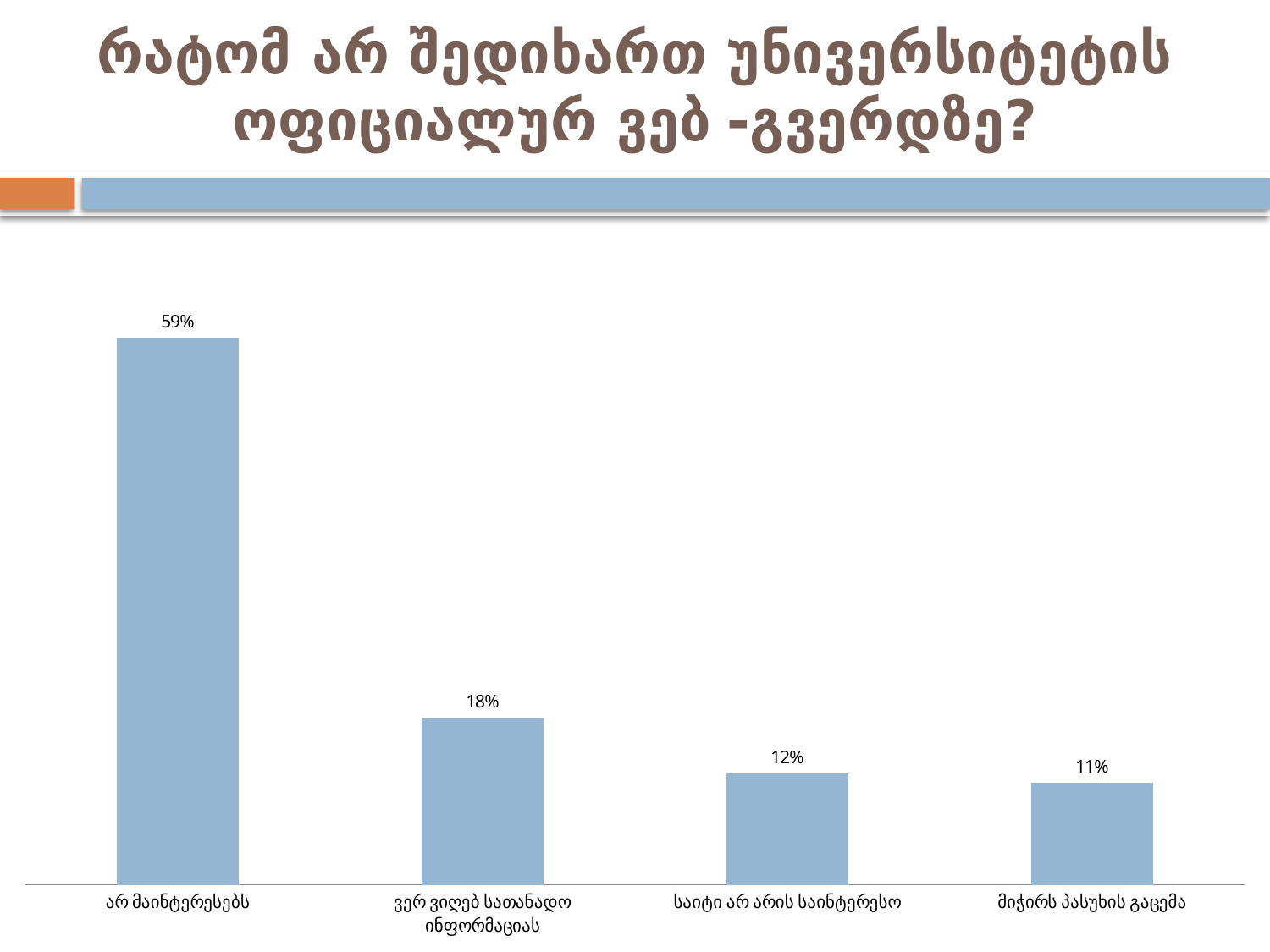
Which is larger, the value for "ვერ ვიღებ სათანადო ინფორმაციას" or the value for "საიტი არ არის საინტერესო"? ვერ ვიღებ სათანადო ინფორმაციას How many categories are shown in the chart? 4 What kind of chart is shown on the slide? Bar chart What value is shown for the category "არ მაინტერესებს"? 59% Which category has the lowest value? მიჭირს პასუხის გაცემა What is the difference between the values for "საიტი არ არის საინტერესო" and "მიჭირს პასუხის გაცემა"? 1% What value is shown for the category "საიტი არ არის საინტერესო"? 12% What is the difference between the values for "არ მაინტერესებს" and "ვერ ვიღებ სათანადო ინფორმაციას"? 41% Which category has the highest value? არ მაინტერესებს What value is shown for the category "მიჭირს პასუხის გაცემა"? 11% What value is shown for the category "ვერ ვიღებ სათანადო ინფორმაციას"? 18% Do the values rise or fall from left to right across the categories? Fall